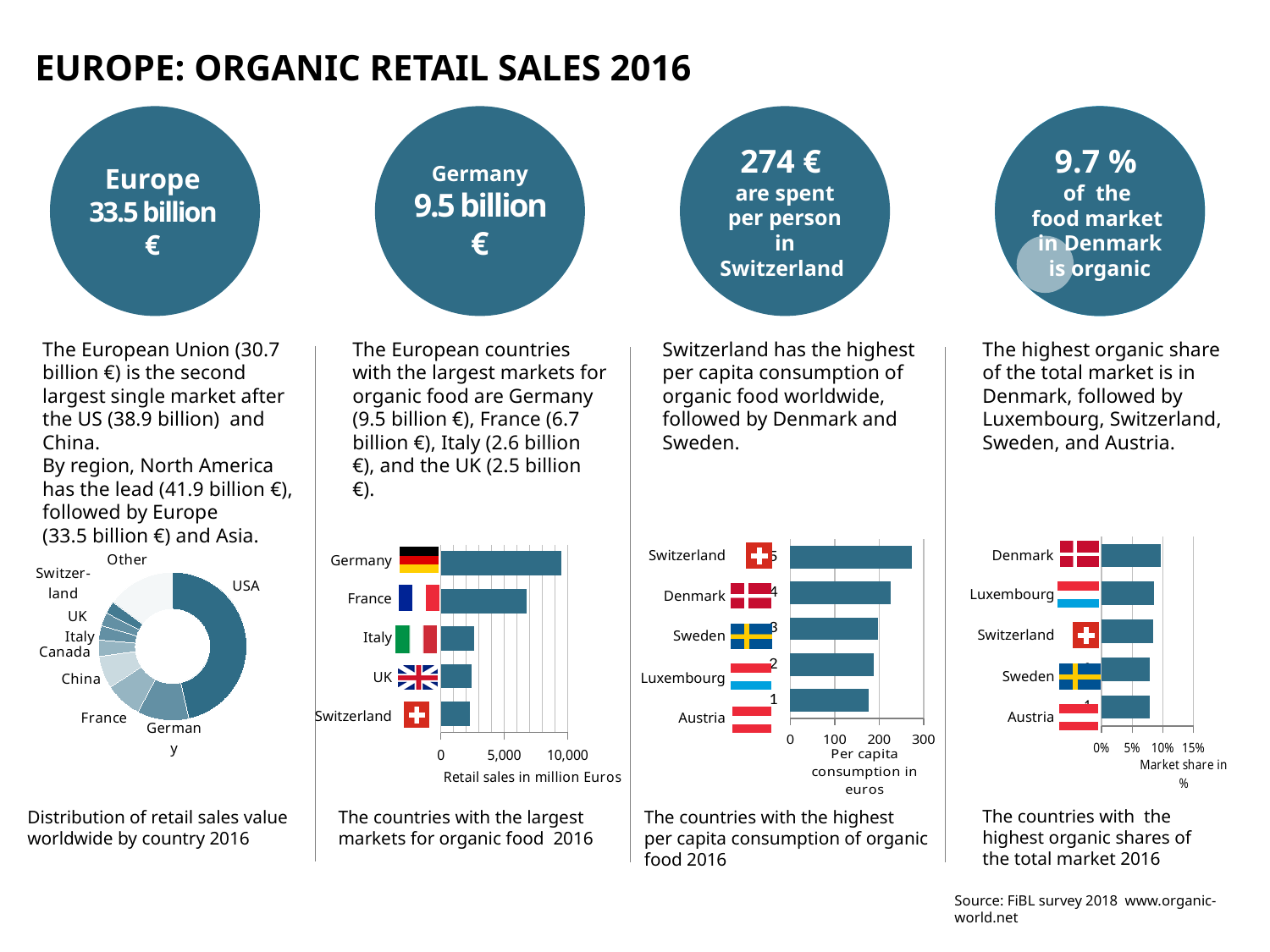
What kind of chart is 'The countries with the largest markets for organic food 2016'? Bar chart In the chart 'The countries with the largest markets for organic food 2016', how many countries are shown? 5 In the chart 'The countries with the largest markets for organic food 2016', is the value for Italy greater or less than 5,000? less In the chart 'The countries with the highest per capita consumption of organic food 2016', is the value for Austria greater or less than 200? less In the chart 'The countries with the highest organic shares of the total market 2016', which country has the highest value? Denmark How many slices does the chart 'Distribution of retail sales value worldwide by country 2016' have? 9 In the chart 'The countries with the largest markets for organic food 2016', is the value for France greater or less than 5,000? greater In the chart 'The countries with the highest per capita consumption of organic food 2016', which country has the highest value? Switzerland In the chart 'Distribution of retail sales value worldwide by country 2016', which country has the largest slice? USA What is the x-axis label of the chart 'The countries with the largest markets for organic food 2016'? Retail sales in million Euros What kind of chart is the chart titled 'Distribution of retail sales value worldwide by country 2016'? Pie (donut) chart